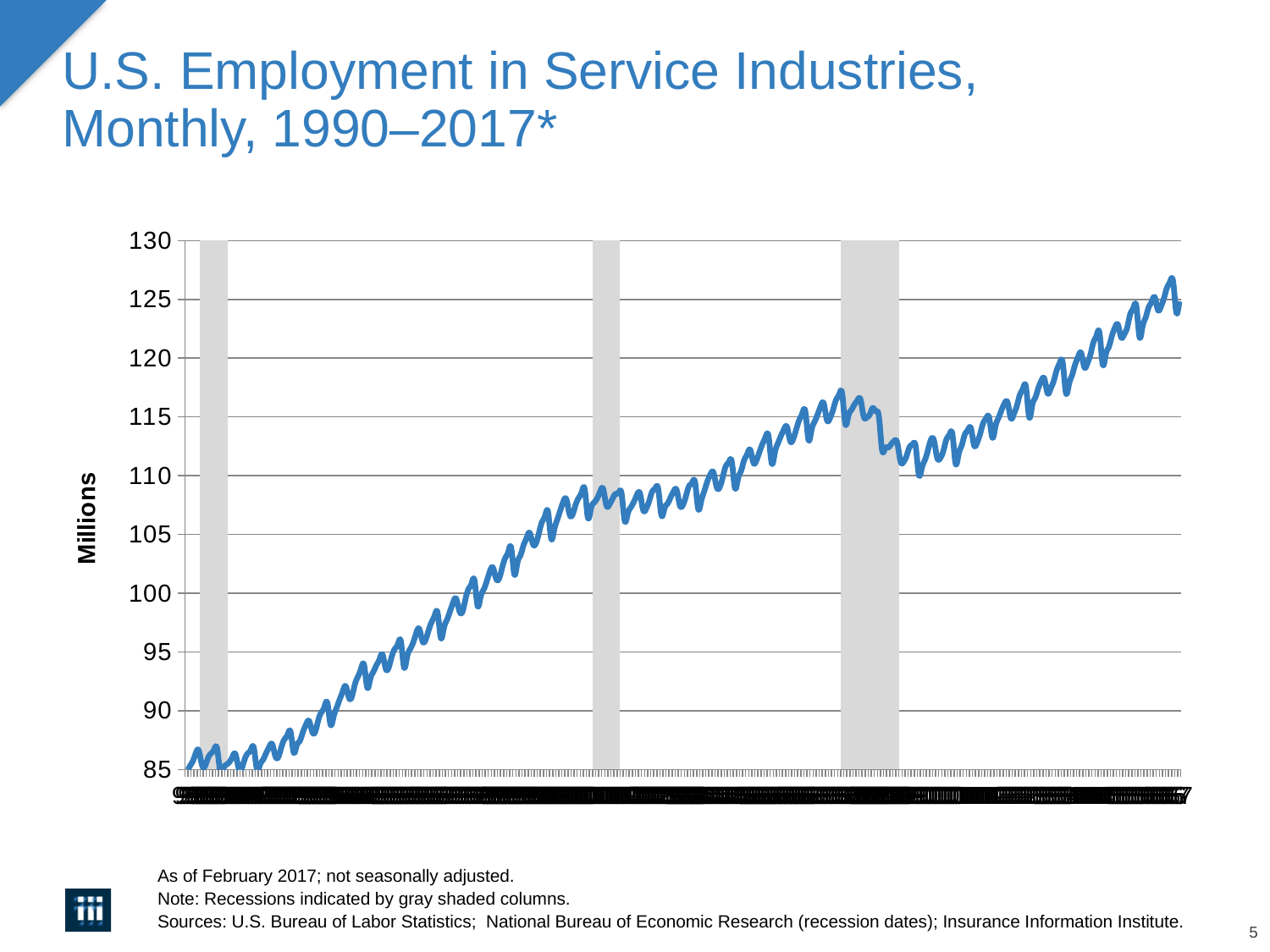
Overall, do the values rise or fall from 1990 to 2017 along the x axis? rise What is the title of the slide's chart? U.S. Employment in Service Industries, Monthly, 1990–2017* Is the lowest value reached just after the third gray shaded column greater or less than 115? less Which is larger, the value at the start of the series in 1990 or the value at the end of the series in 2017? 2017 Is the peak reached just before the third gray shaded column greater or less than 115? greater Is the value at the start of the series (1990) greater or less than 90? less What kind of chart is shown on the slide? line chart What is the label on the vertical axis? Millions How many gray shaded recession columns are shown on the chart? 3 During the third gray shaded column, does the line rise or fall? fall